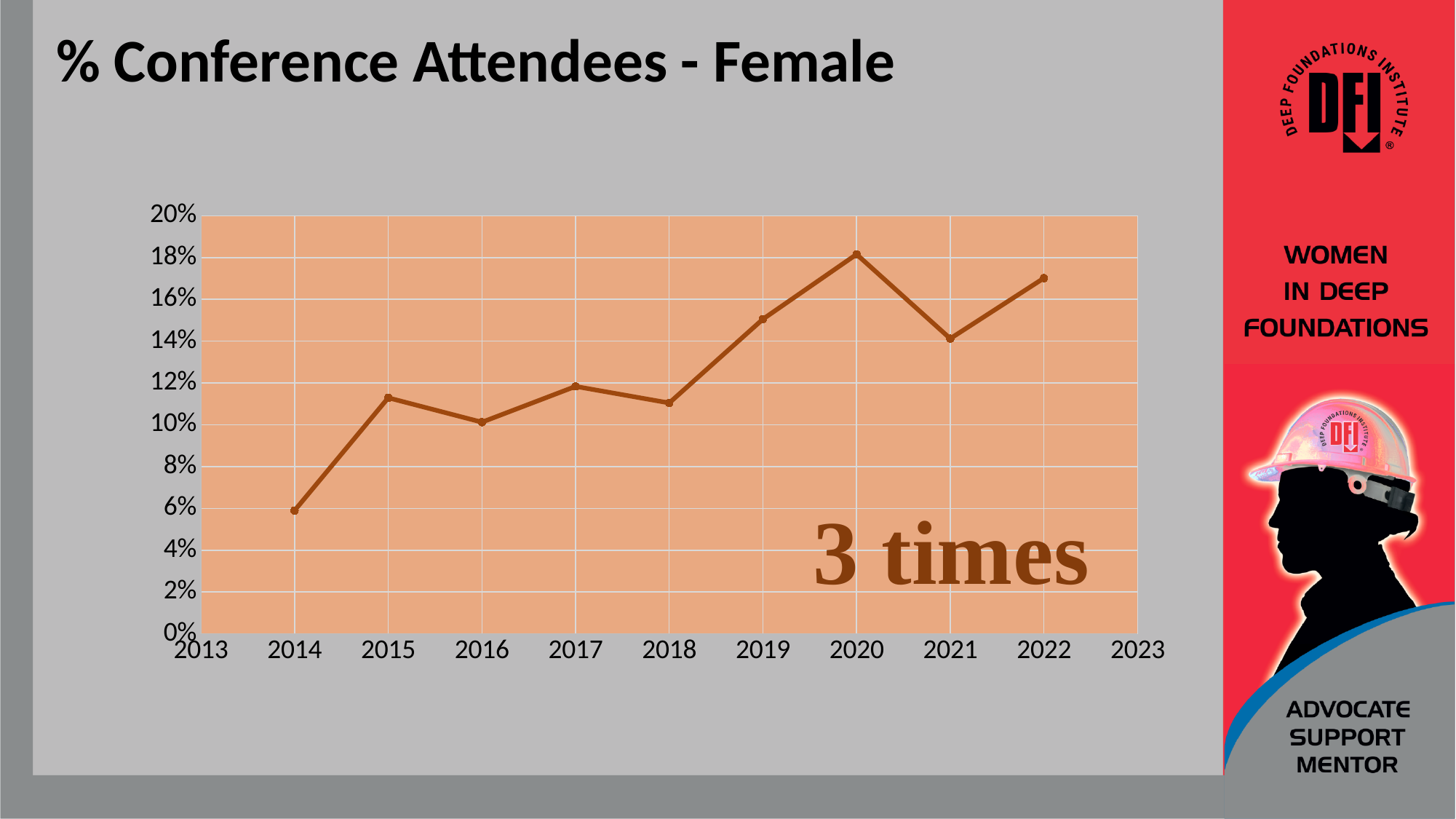
Which year has the highest value? 2020 Is the value for 2014 greater or less than 8%? less Which year has the larger value, 2021 or 2022? 2022 What kind of chart is shown on the slide? line chart Overall, do the values rise or fall from 2014 to 2022? rise Which year has the lowest value? 2014 Is the value for 2016 greater or less than 12%? less What is the title of the chart? % Conference Attendees - Female Is the value for 2020 greater or less than 16%? greater How many data points are plotted on the line? 9 Which year has the larger value, 2015 or 2019? 2019